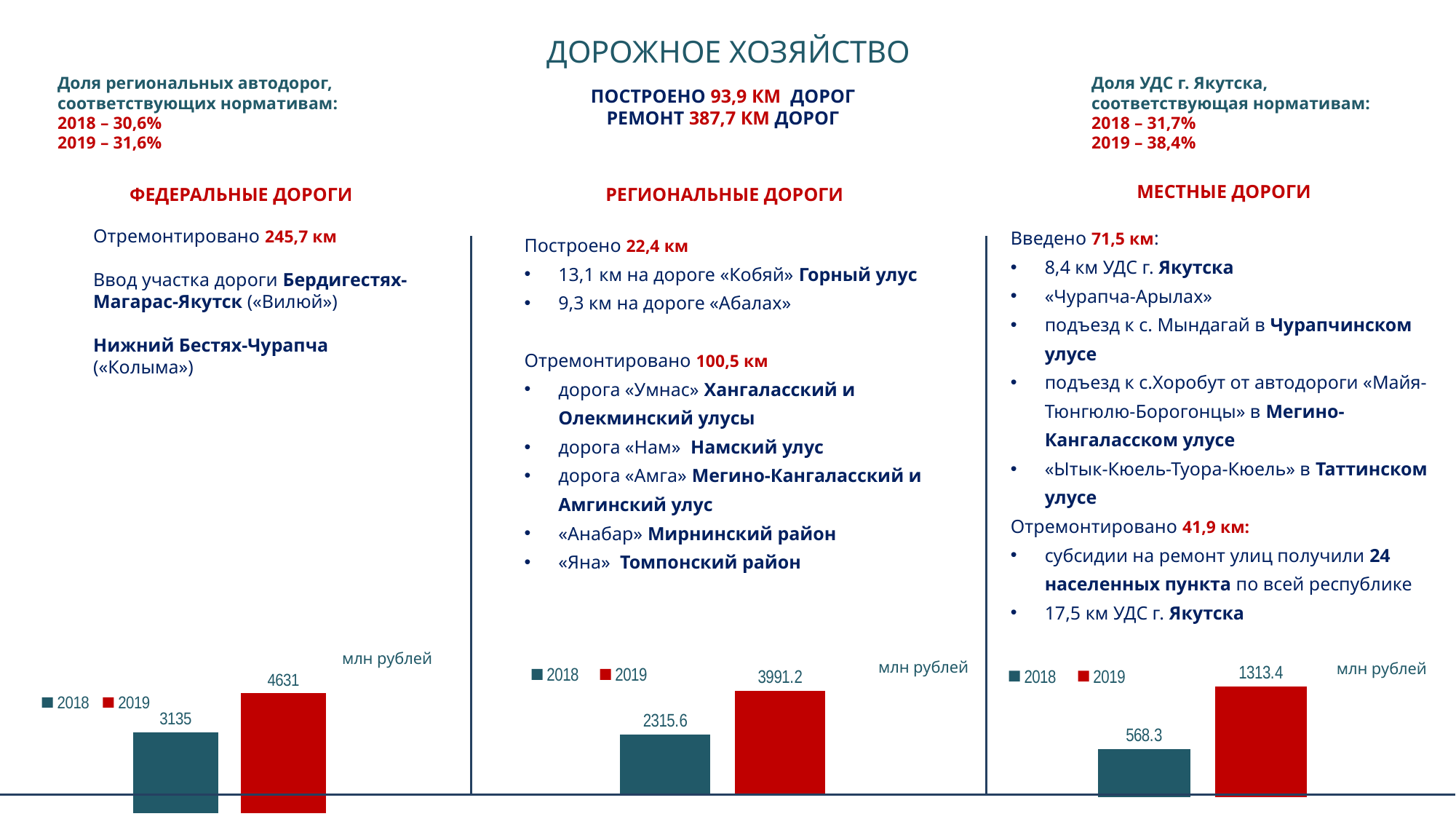
In the right chart (under МЕСТНЫЕ ДОРОГИ), which year has the lowest value? 2018 In the middle chart (under РЕГИОНАЛЬНЫЕ ДОРОГИ), which year has the higher value, 2018 or 2019? 2019 In the left chart (under ФЕДЕРАЛЬНЫЕ ДОРОГИ), what is the difference between the 2019 and 2018 values? 1496 In the left chart (under ФЕДЕРАЛЬНЫЕ ДОРОГИ), what is the value for 2019? 4631 In the right chart (under МЕСТНЫЕ ДОРОГИ), what is the value for 2019? 1313.4 What kind of chart is the right chart (under МЕСТНЫЕ ДОРОГИ)? bar chart In the middle chart (under РЕГИОНАЛЬНЫЕ ДОРОГИ), what is the value for 2018? 2315.6 In the middle chart (under РЕГИОНАЛЬНЫЕ ДОРОГИ), what is the value for 2019? 3991.2 What unit is shown next to the left chart (under ФЕДЕРАЛЬНЫЕ ДОРОГИ)? млн рублей In the left chart (under ФЕДЕРАЛЬНЫЕ ДОРОГИ), what is the value for 2018? 3135 In the right chart (under МЕСТНЫЕ ДОРОГИ), what is the value for 2018? 568.3 How many series does the legend of the middle chart (under РЕГИОНАЛЬНЫЕ ДОРОГИ) list? 2